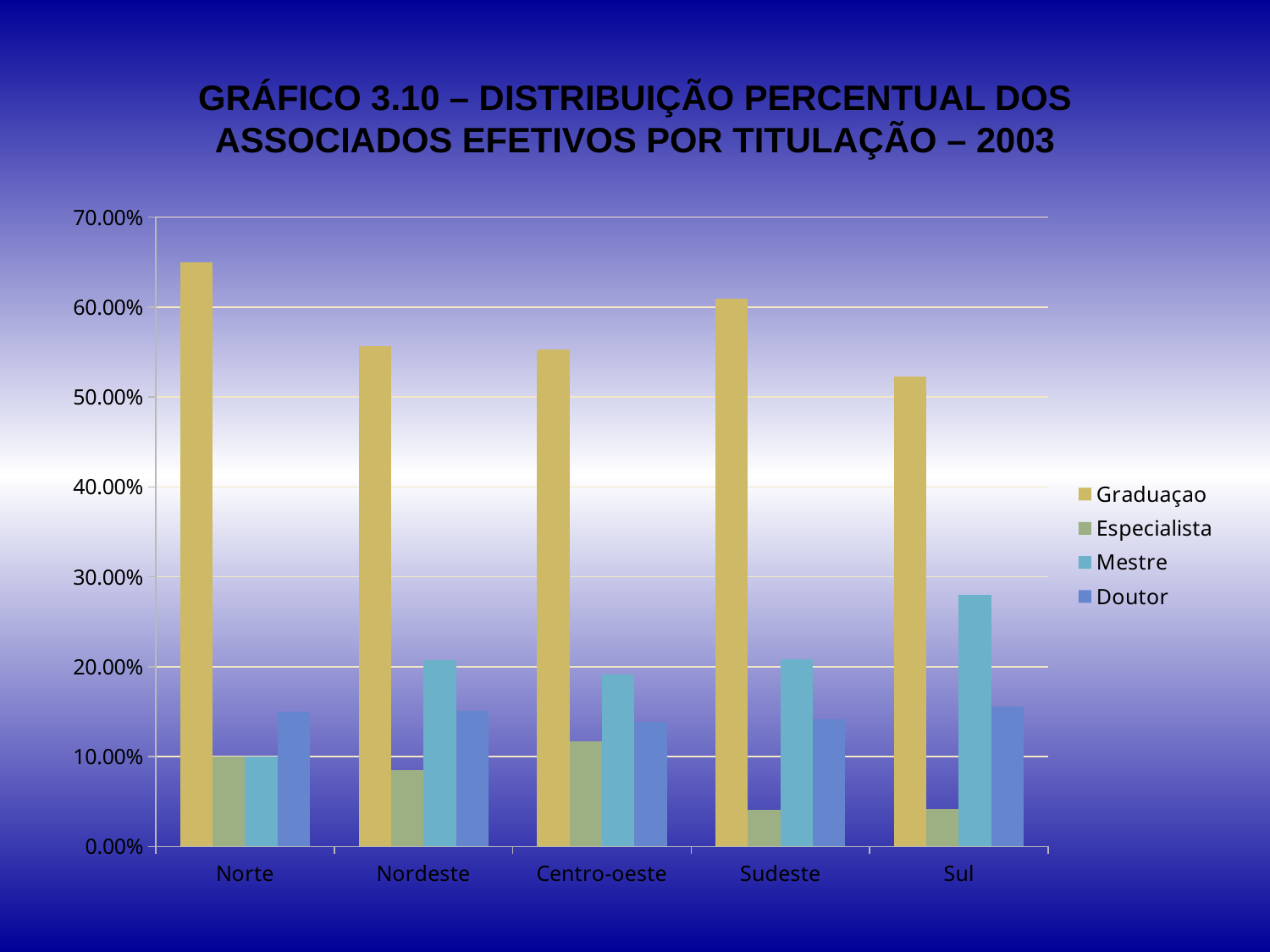
Which region has the lowest value for Graduaçao? Sul Which is larger: Graduaçao in Sudeste or Graduaçao in Sul? Sudeste Is the value for Especialista in Sudeste greater or less than 10.00%? less How many series does the legend list? 4 Which region has the highest value for Mestre? Sul How many regions are shown on the x axis? 5 What kind of chart is shown on the slide? bar chart In Sudeste, which is larger: Mestre or Especialista? Mestre Is the value for Mestre in Sul greater or less than 20.00%? greater Is the value for Graduaçao in Norte greater or less than 60.00%? greater Which series is listed first in the legend? Graduaçao Which region has the highest value for Graduaçao? Norte